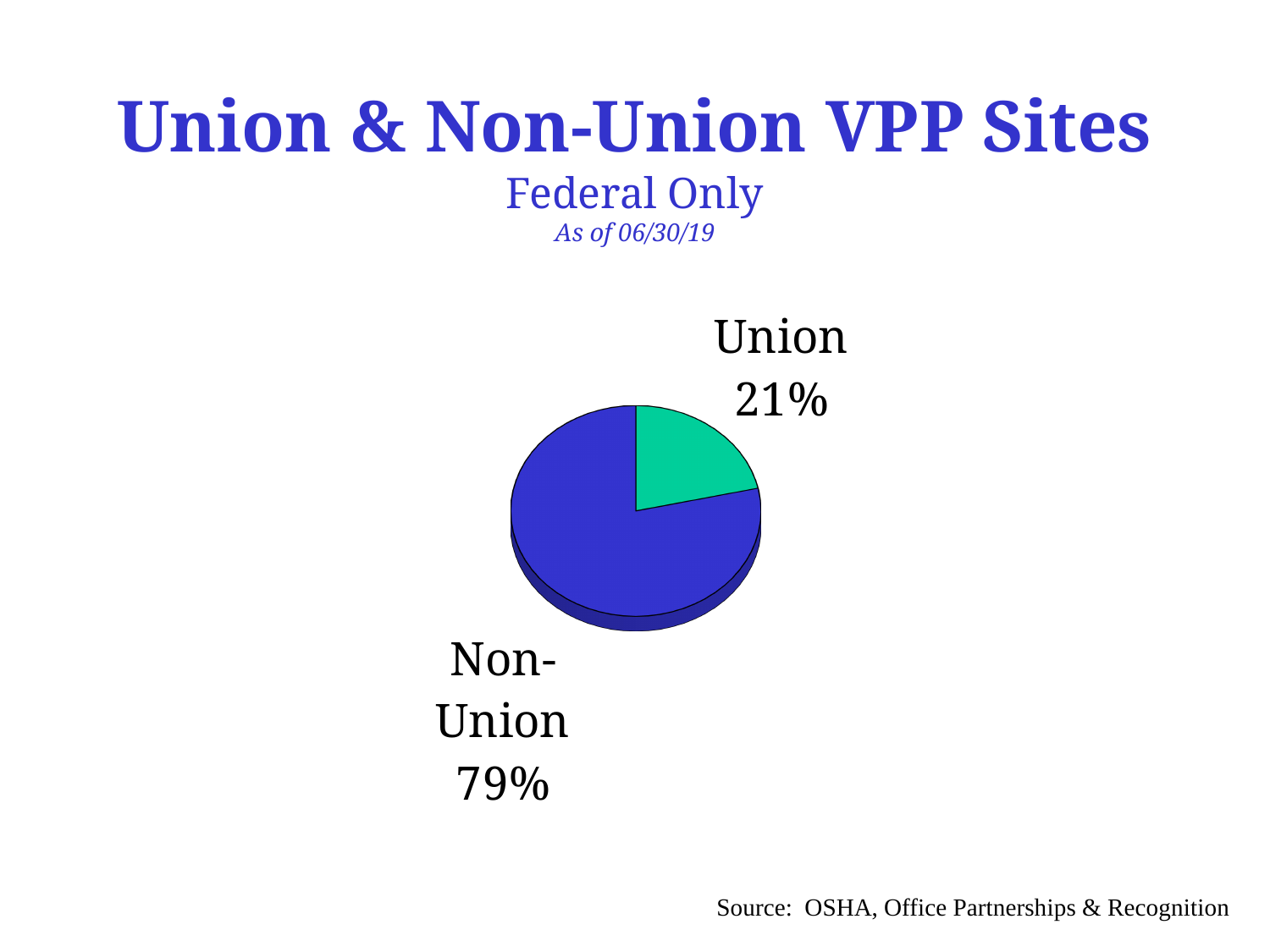
What share of Federal VPP sites are Union? 21% Which category has the largest share of the pie? Non-Union How many slices does the pie chart have? 2 What share of Federal VPP sites are Non-Union? 79% Which category has the smallest share of the pie? Union What kind of chart is shown on the slide? Pie chart What is the title of the chart on the slide? Union & Non-Union VPP Sites Which is larger, the Union share or the Non-Union share? Non-Union What is the difference in percentage points between the Non-Union and Union shares? 58 As of what date is the data on the slide reported? 06/30/19